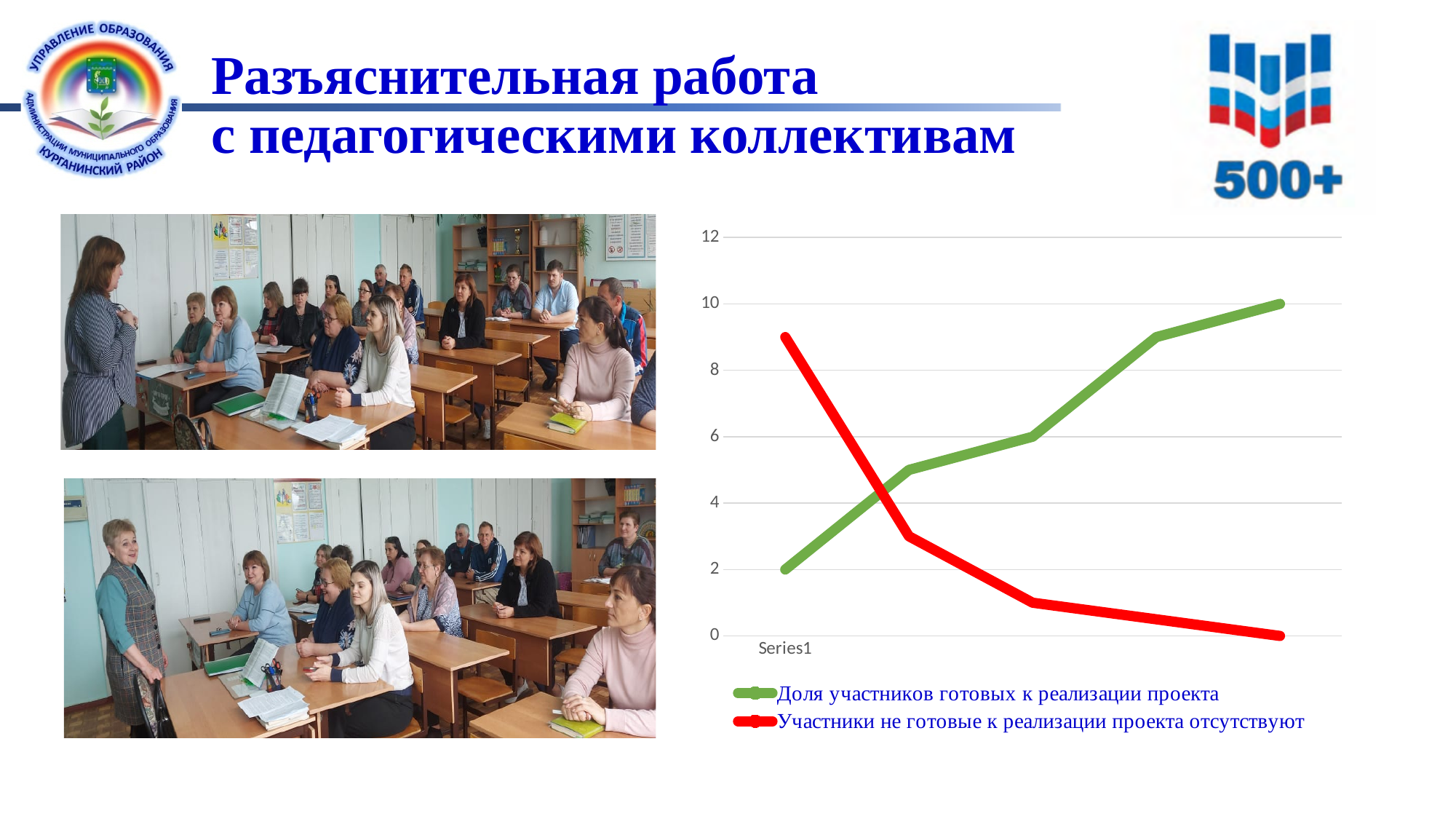
What is the value of the first (leftmost) point of the green line, at Series1? 2 How many series does the chart legend list? 2 What colour is the line for 'Доля участников готовых к реализации проекта'? green What kind of chart is shown on the slide? line chart Is the value of the first point of the red line, at Series1, greater or less than 8? greater Does the red line (Участники не готовые к реализации проекта отсутствуют) rise or fall from left to right? fall At the first point (Series1), which line has the higher value, the green or the red? red Does the green line (Доля участников готовых к реализации проекта) rise or fall from left to right? rise Is the value of the third point of the red line greater or less than 2? less What is the value of the last (rightmost) point of the green line? 10 What is the value of the last (rightmost) point of the red line? 0 How many data points does each line in the chart have? 5